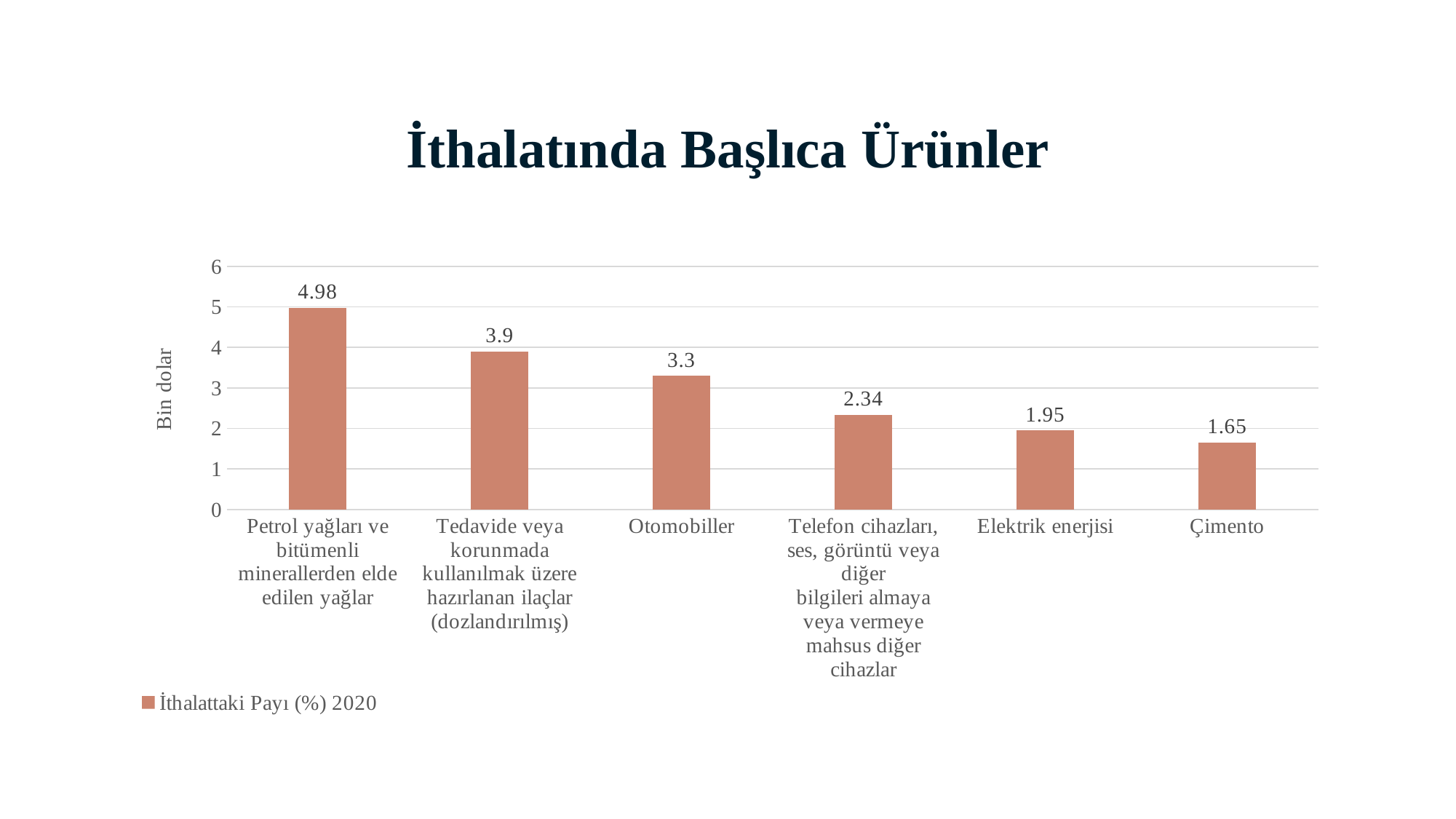
Which category has the highest value? Petrol yağları ve bitümenli minerallerden elde edilen yağlar Which category has the lowest value? Çimento What is the value for Çimento? 1.65 Which is larger, the value for Otomobiller or the value for Elektrik enerjisi? Otomobiller How many categories are shown on the x axis? 6 What kind of chart is shown on the slide? bar chart What is the difference between the highest value (4.98) and the value for Elektrik enerjisi? 3.03 Is the value for Otomobiller greater or less than 3? greater What is the value for Otomobiller? 3.3 What is the title of the chart? İthalatında Başlıca Ürünler What is the difference between the value for Otomobiller and the value for Çimento? 1.65 What is the value for Elektrik enerjisi? 1.95